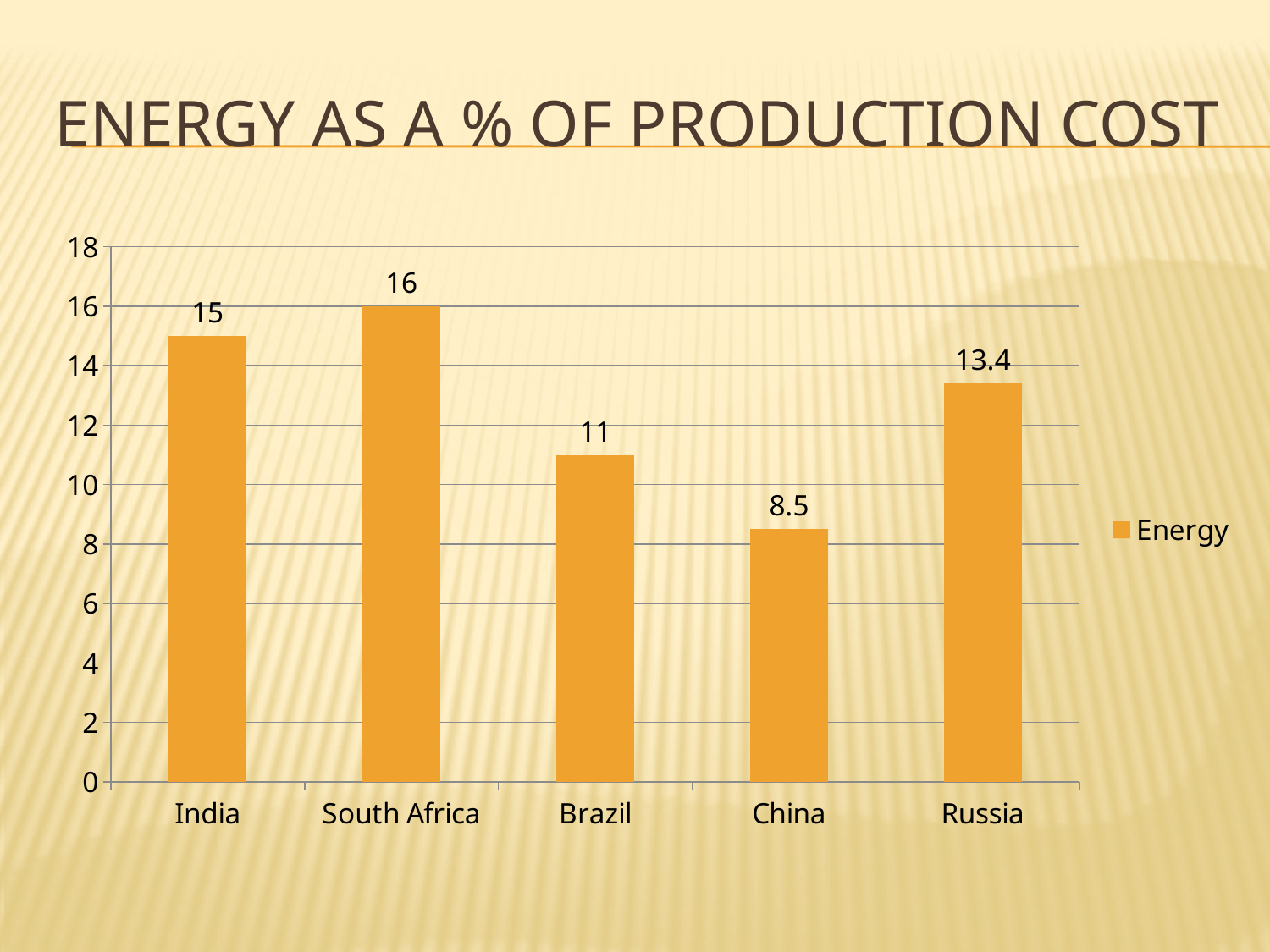
How many countries are shown on the chart? 5 What is the value for Russia? 13.4 What is the value for India? 15 What is the value for China? 8.5 What kind of chart is shown on the slide? bar chart Which is larger, the value for Brazil or the value for Russia? Russia What series name is listed in the legend? Energy Is the value for Brazil greater or less than 10? greater What is the difference between the values for South Africa and Brazil? 5 Which country has the lowest value? China Which country has the highest value? South Africa What is the difference between the values for India and China? 6.5